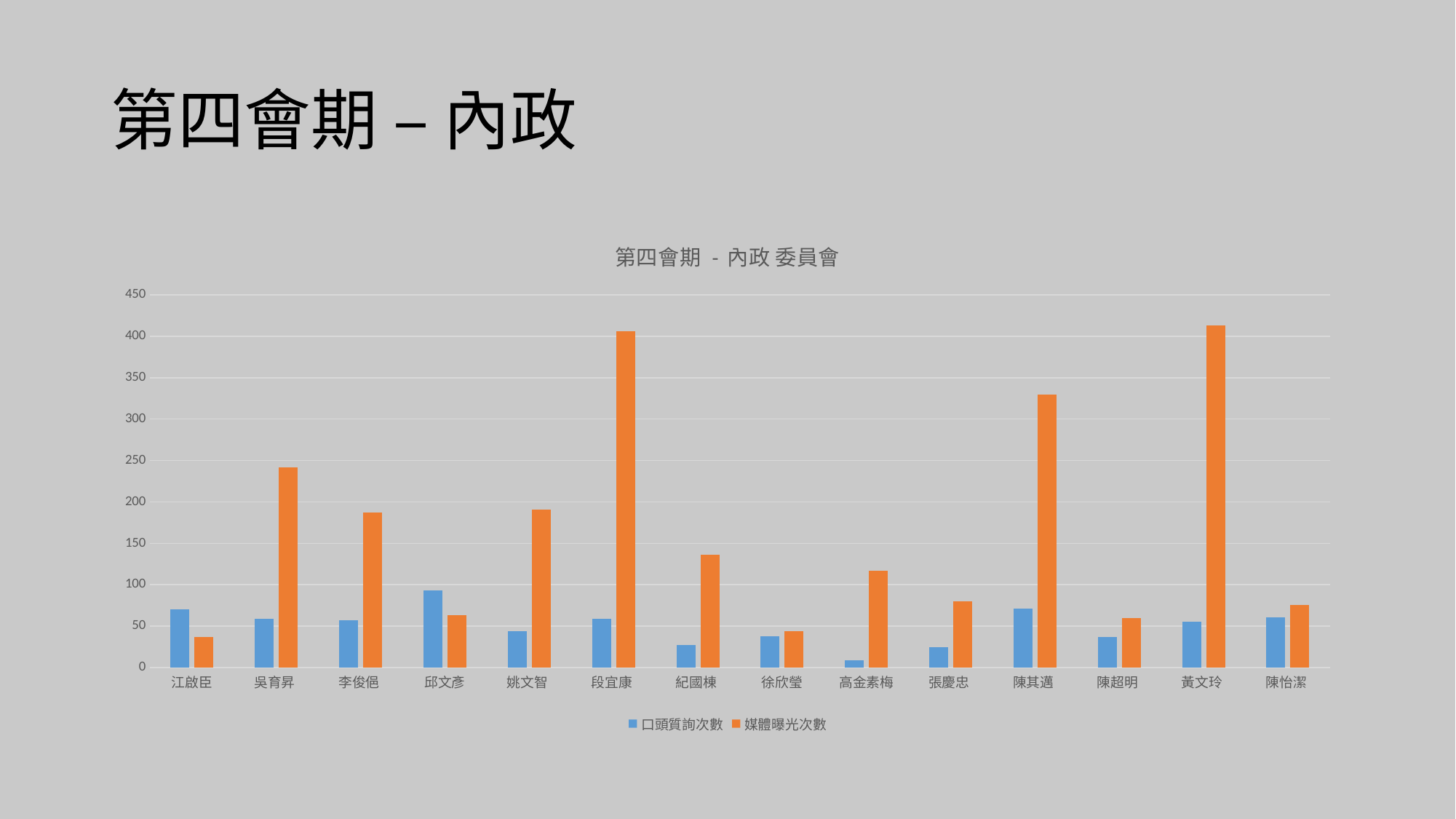
How many series does the legend list? 2 For 江啟臣, which is larger: 口頭質詢次數 or 媒體曝光次數? 口頭質詢次數 Which series is shown in orange? 媒體曝光次數 What is the title of the chart? 第四會期 - 內政 委員會 What kind of chart is shown on the slide? bar chart Which legislator has the lowest 口頭質詢次數? 高金素梅 Which legislator has the highest 口頭質詢次數? 邱文彥 Is the 媒體曝光次數 value for 段宜康 greater or less than 350? greater Is the 媒體曝光次數 value for 陳其邁 greater or less than 300? greater Which has the larger 媒體曝光次數: 陳其邁 or 吳育昇? 陳其邁 How many legislators (categories) are shown on the x axis? 14 Is the 口頭質詢次數 value for 邱文彥 greater or less than 100? less